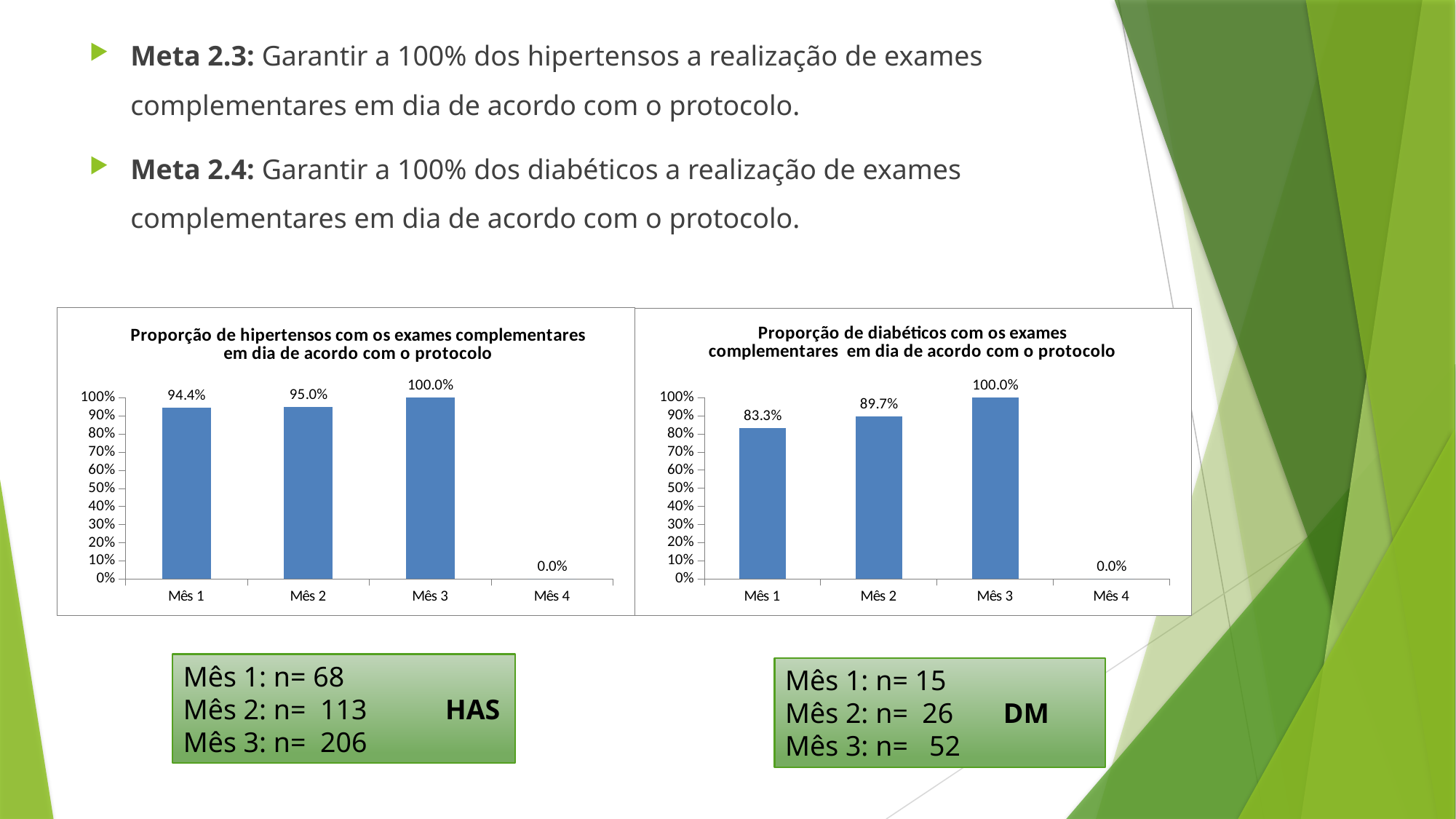
In the left chart (hipertensos), what is the value for Mês 2? 95.0% In the right chart (diabéticos), which month has the highest value? Mês 3 In the right chart (diabéticos), what is the value for Mês 2? 89.7% In the right chart (diabéticos), what is the difference between the values for Mês 3 and Mês 1? 16.7% In the right chart (Proporção de diabéticos com os exames complementares em dia de acordo com o protocolo), what is the value for Mês 1? 83.3% In the left chart (hipertensos), what is the difference between the values for Mês 2 and Mês 1? 0.6% How many months (categories) are shown on the x axis of the left chart (hipertensos)? 4 What kind of chart is the right chart (diabéticos)? Bar chart In the right chart (diabéticos), do the values rise or fall from Mês 1 to Mês 3? Rise In the left chart (Proporção de hipertensos com os exames complementares em dia de acordo com o protocolo), what is the value for Mês 1? 94.4% In the left chart (hipertensos), which month has the lowest value? Mês 4 Which is larger: the Mês 1 value in the left chart (hipertensos) or the Mês 1 value in the right chart (diabéticos)? Left chart (hipertensos), 94.4%